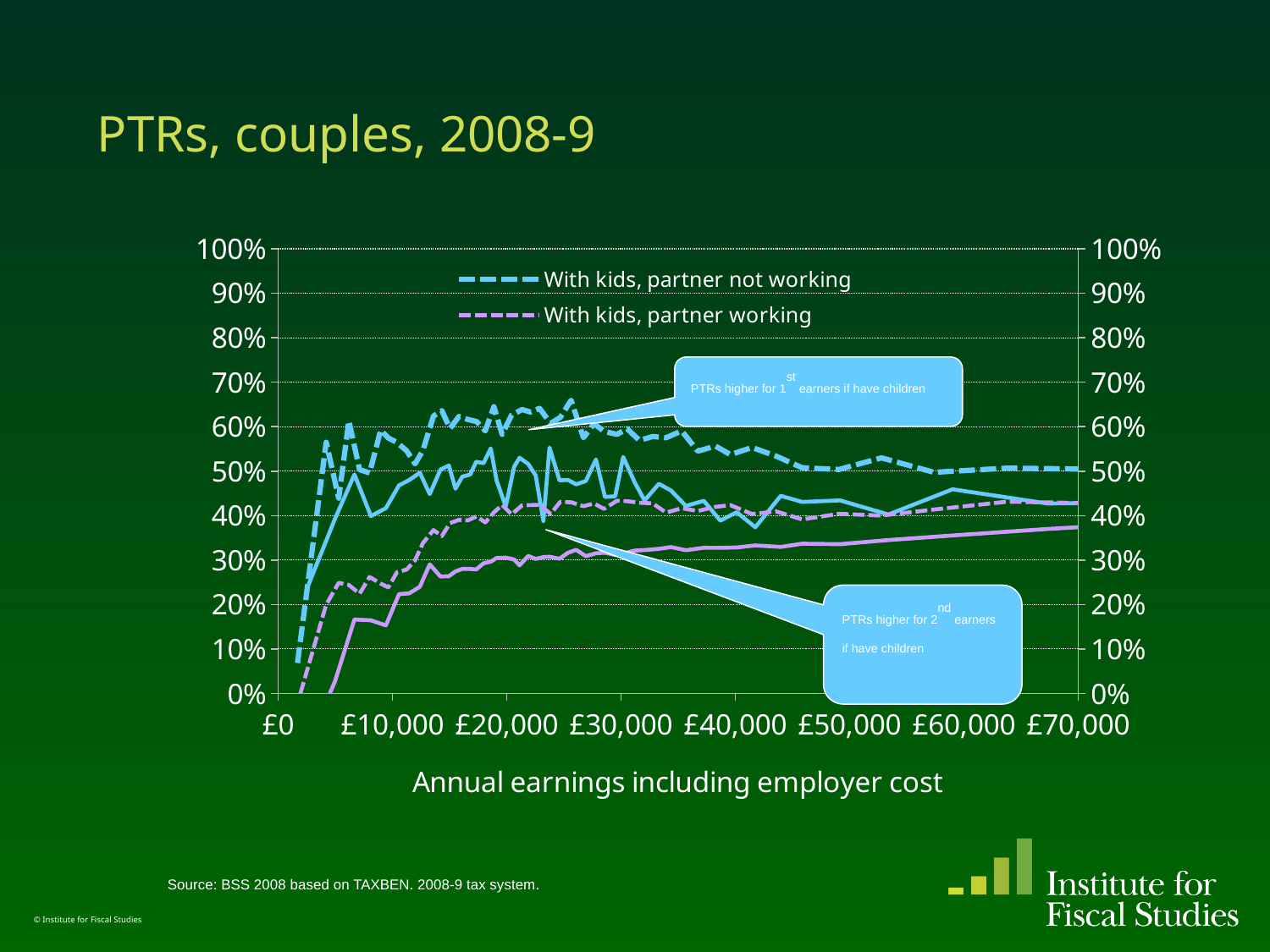
Is the value of the 'With kids, partner working' line at £70,000 greater or less than 40%? greater What is the title of the chart on the slide? PTRs, couples, 2008-9 Is the value of the 'With kids, partner working' line at £10,000 greater or less than 30%? less What kind of chart is shown on the slide? Line chart How many series does the chart's legend list? 2 What is the highest value shown on the y axis? 100% Does the 'With kids, partner not working' line rise or fall between £20,000 and £70,000? Fall At £40,000, which line is higher: 'With kids, partner not working' or 'With kids, partner working'? With kids, partner not working How many labelled tick marks are shown on the x axis? 8 Is the value of the 'With kids, partner not working' line at £60,000 greater or less than 60%? less What is the label of the x axis? Annual earnings including employer cost